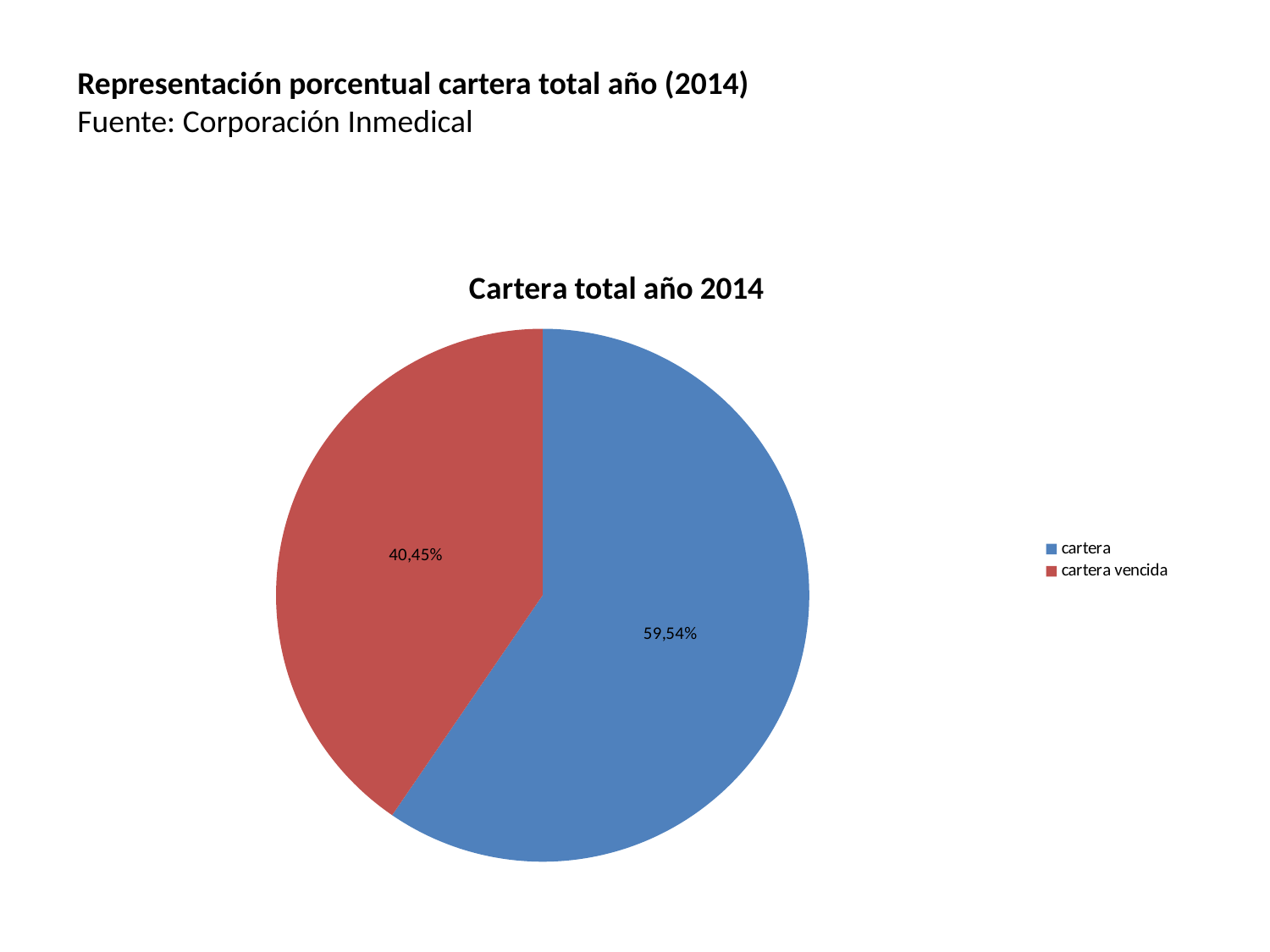
Which is larger, the 'cartera' slice or the 'cartera vencida' slice? cartera What is the title of the chart? Cartera total año 2014 What colour is the 'cartera vencida' slice? red What kind of chart is shown on the slide? pie chart What share of the pie does 'cartera' represent? 59,54% What percentage is shown for the 'cartera' slice? 59,54% How many slices does the pie chart have? 2 What percentage is shown for the 'cartera vencida' slice? 40,45% Which slice is the smallest in the pie chart? cartera vencida How many entries does the legend list? 2 Which slice is the largest in the pie chart? cartera